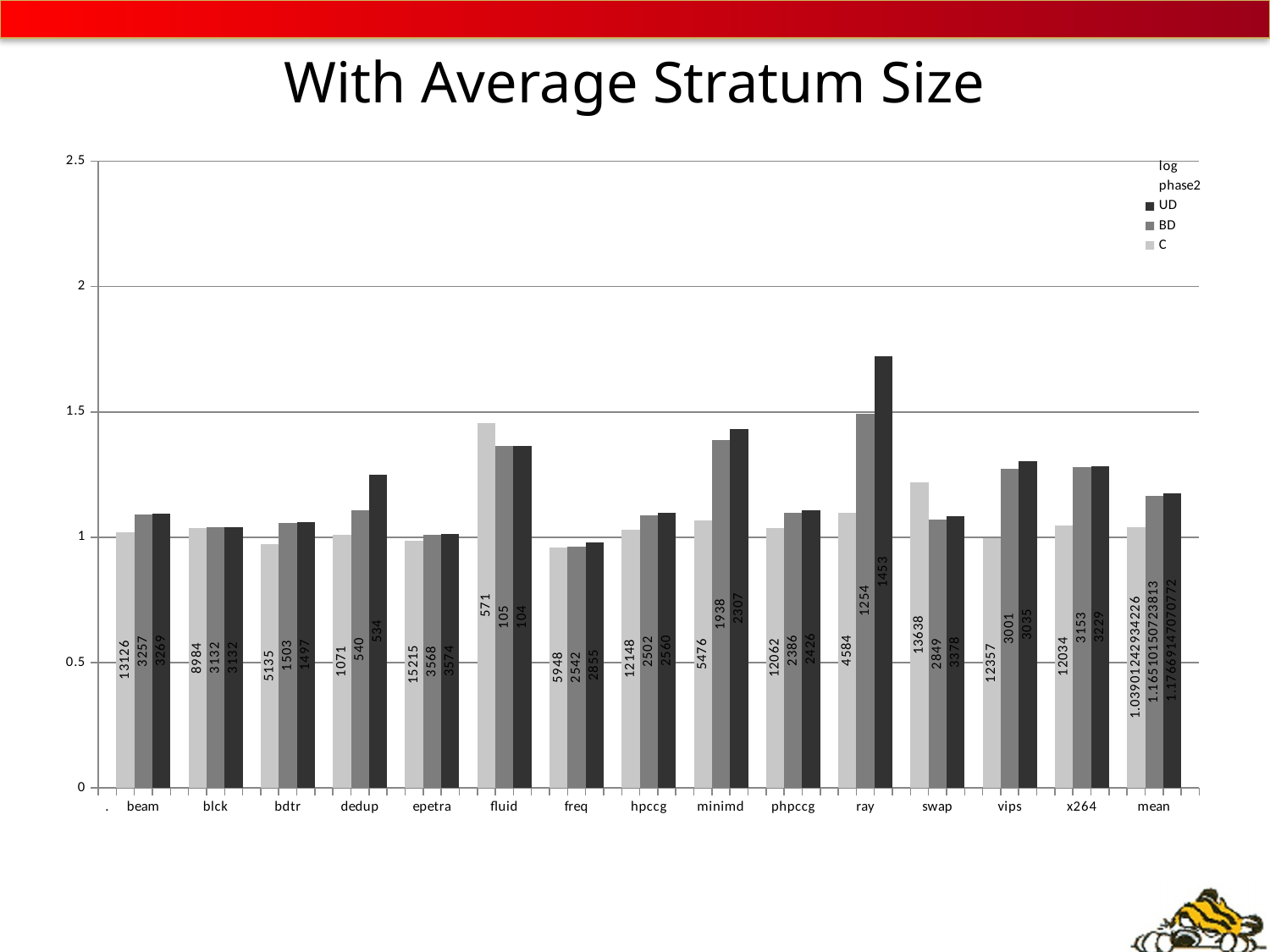
What is the title of the chart? With Average Stratum Size What kind of chart is shown on the slide? bar chart For fluid, which is larger, the C bar or the UD bar? C What is the value of the UD bar for mean? 1.17669147070772 Is the C value for freq greater or less than 1? less How many series does the legend list? 5 Which series is shown with the darkest bars according to the legend? UD Is the UD value for ray greater or less than 1.5? greater What is the value of the C bar for mean? 1.03901242934226 Which category has the tallest bar in the chart? ray How many categories are shown along the x axis (including mean)? 15 What is the value of the BD bar for mean? 1.16510150723813